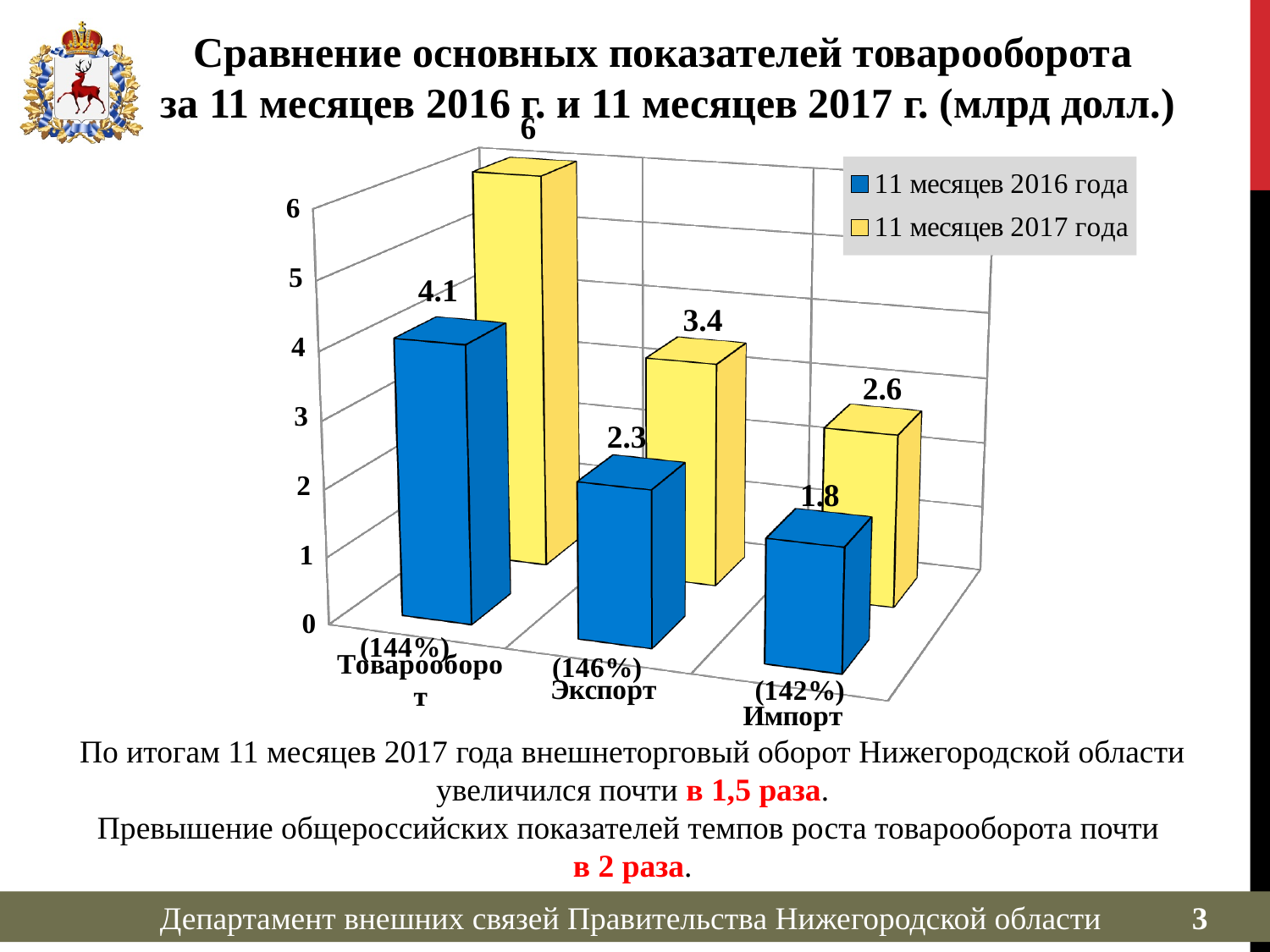
Which is larger: the Импорт value for 11 месяцев 2017 года or the Экспорт value for 11 месяцев 2016 года? Импорт value for 11 месяцев 2017 года What is the difference between the 11 месяцев 2017 года and 11 месяцев 2016 года values for Экспорт? 1.1 What is the value for Экспорт in the 11 месяцев 2017 года series? 3.4 What is the value for Товарооборот in the 11 месяцев 2016 года series? 4.1 What kind of chart is shown on the slide? Bar chart What is the value for Товарооборот in the 11 месяцев 2017 года series? 6 What percentage is shown under the Экспорт category label? (146%) How many series does the legend list? 2 Which category has the highest value in the 11 месяцев 2016 года series? Товарооборот Which category has the lowest value in the 11 месяцев 2017 года series? Импорт How many categories are shown on the x axis? 3 What is the value for Импорт in the 11 месяцев 2016 года series? 1.8